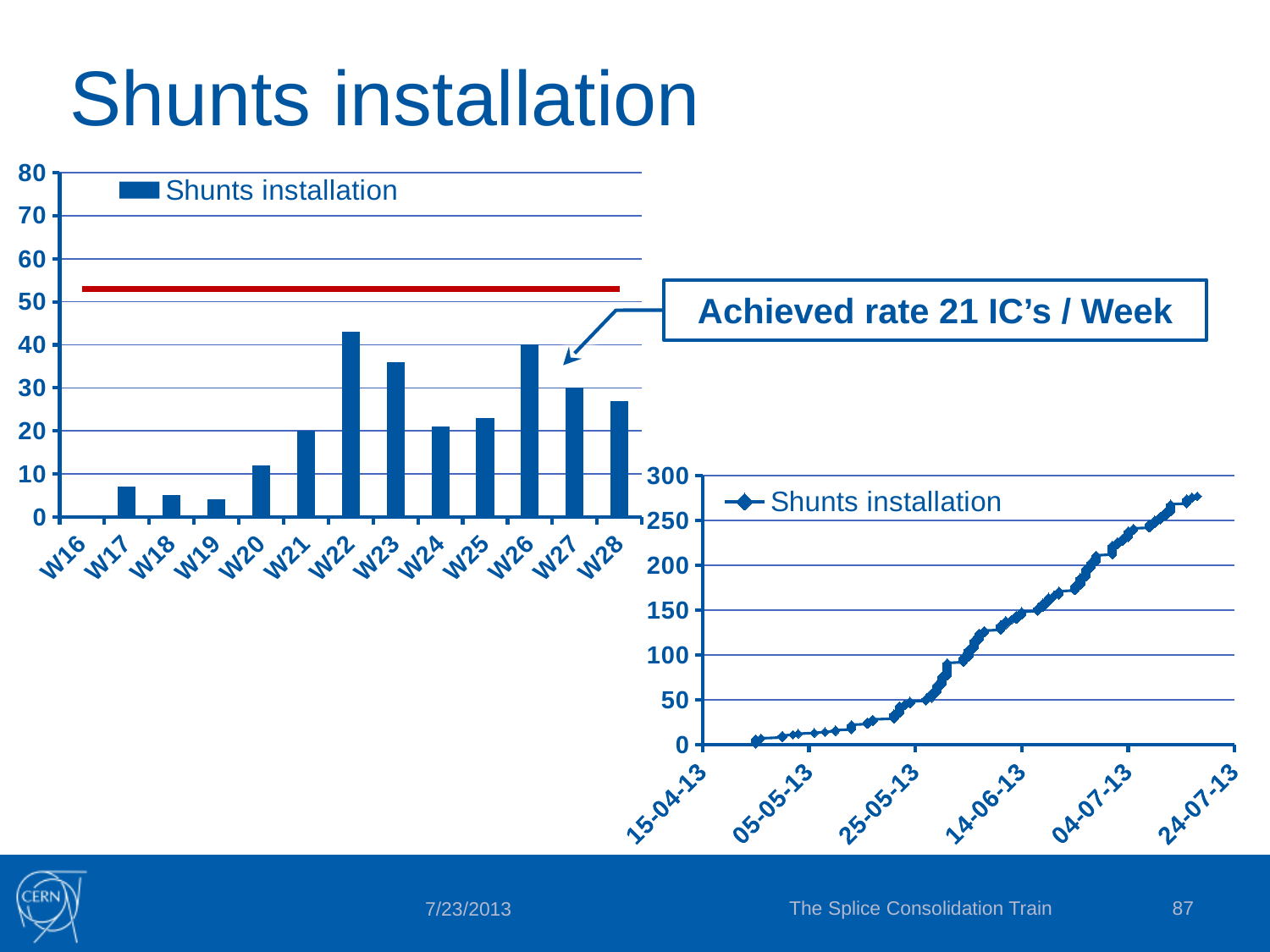
In the top-left bar chart, which week has the highest bar? W22 In the top-left bar chart, which is larger, the value for W23 or the value for W27? W23 What kind of chart is the bottom-right chart on the slide? line chart In the top-left bar chart, is the value for W19 greater or less than 10? less In the top-left bar chart, is the value for W22 greater or less than 40? greater In the bottom-right line chart, is the final value (around 24-07-13) greater or less than 250? greater What kind of chart is the top-left chart on the slide? bar chart How many series does the legend of the top-left bar chart list? 1 In the top-left bar chart, which is larger, the value for W20 or the value for W21? W21 In the bottom-right line chart, do the values rise or fall over time along the x axis? rise In the top-left bar chart, how many weeks are shown on the x axis? 13